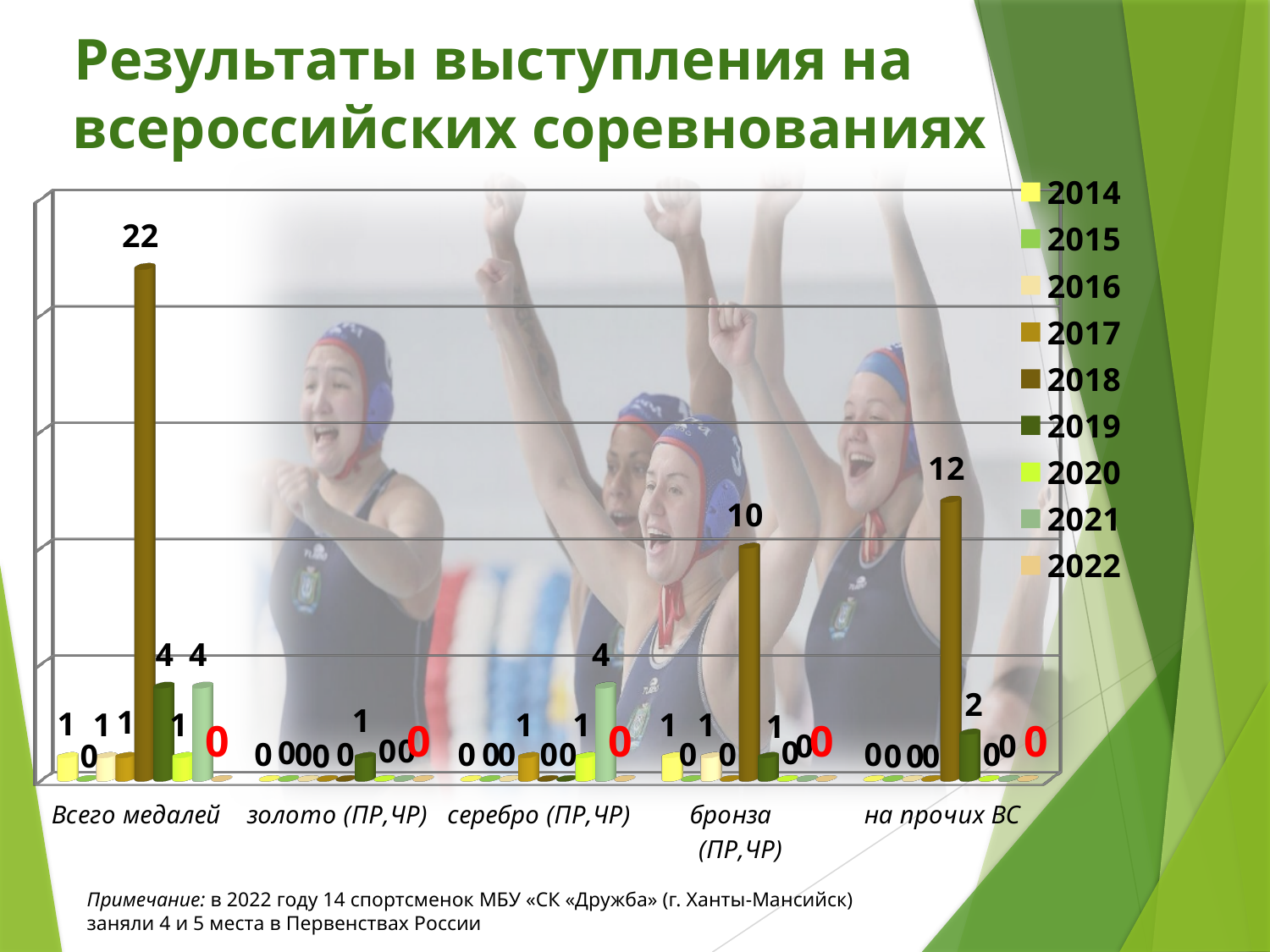
What kind of chart is shown on the slide? bar chart What is the value for 2018 in the 'Всего медалей' category? 22 What is the value for 2021 in the 'серебро (ПР,ЧР)' category? 4 How many series does the legend list? 9 In which category does the 2018 series have its highest value? Всего медалей What is the value for 2018 in the 'на прочих ВС' category? 12 Which is larger for 2018: the value for 'бронза (ПР,ЧР)' or the value for 'на прочих ВС'? на прочих ВС How many categories are shown on the x axis? 5 What is the value for 2018 in the 'бронза (ПР,ЧР)' category? 10 What is the value for 2019 in the 'на прочих ВС' category? 2 What is the value for 2019 in the 'золото (ПР,ЧР)' category? 1 What is the difference between the 2018 values for 'Всего медалей' and 'бронза (ПР,ЧР)'? 12